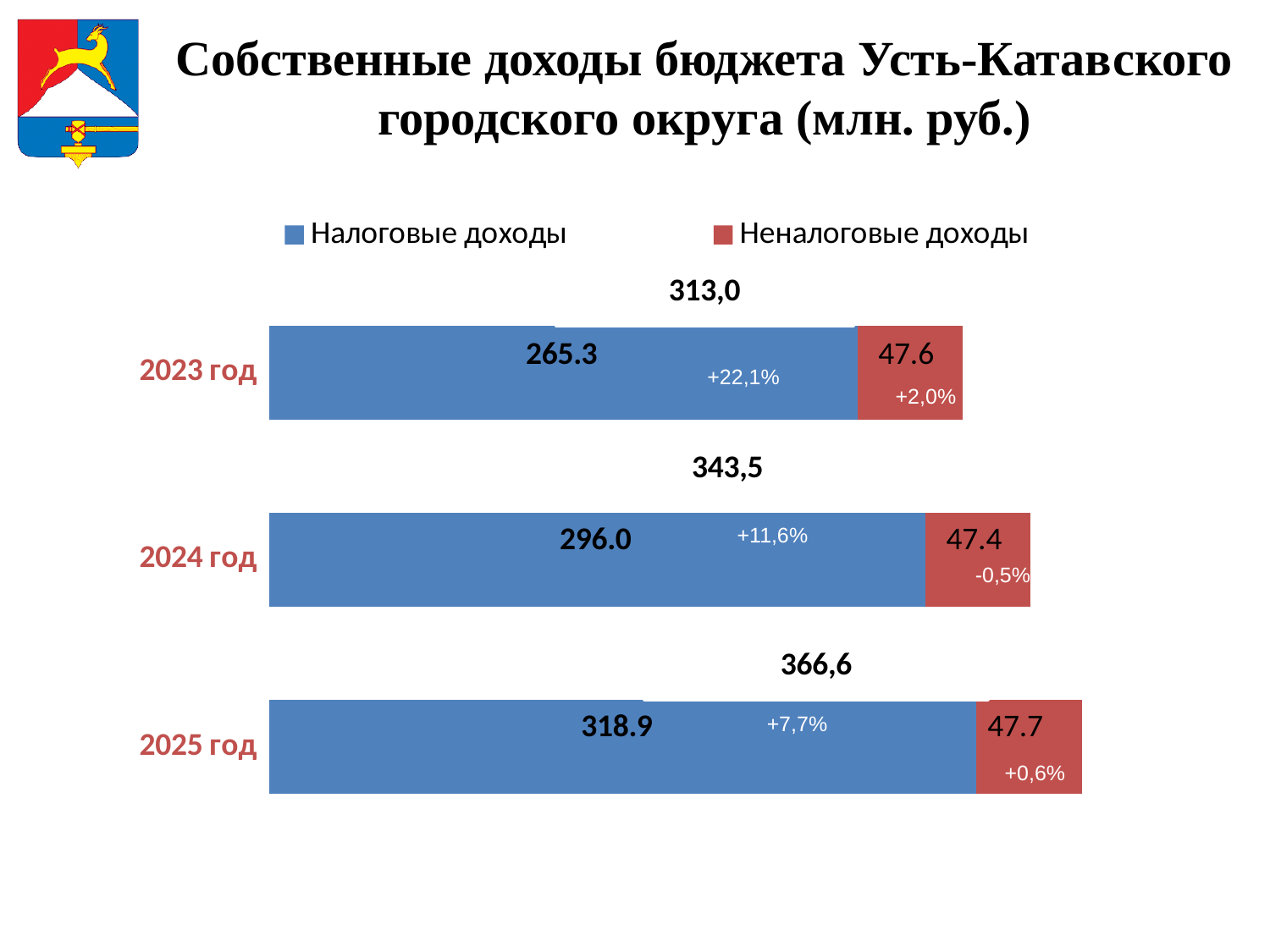
How many years (categories) are shown in the chart? 3 What kind of chart is shown on the slide? Stacked horizontal bar chart Which year has the highest value of Налоговые доходы? 2025 год What is the total shown above the stacked bar for 2025 год? 366,6 What is the value of Неналоговые доходы for 2024 год? 47.4 Which is larger: Налоговые доходы in 2024 год or Налоговые доходы in 2023 год? 2024 год What is the difference between Налоговые доходы in 2025 год and 2024 год? 22.9 What is the value of Налоговые доходы for 2023 год? 265.3 How many series does the legend list? 2 Which year has the lowest value of Неналоговые доходы? 2024 год What is the total shown above the stacked bar for 2024 год? 343,5 What is the value of Налоговые доходы for 2025 год? 318.9